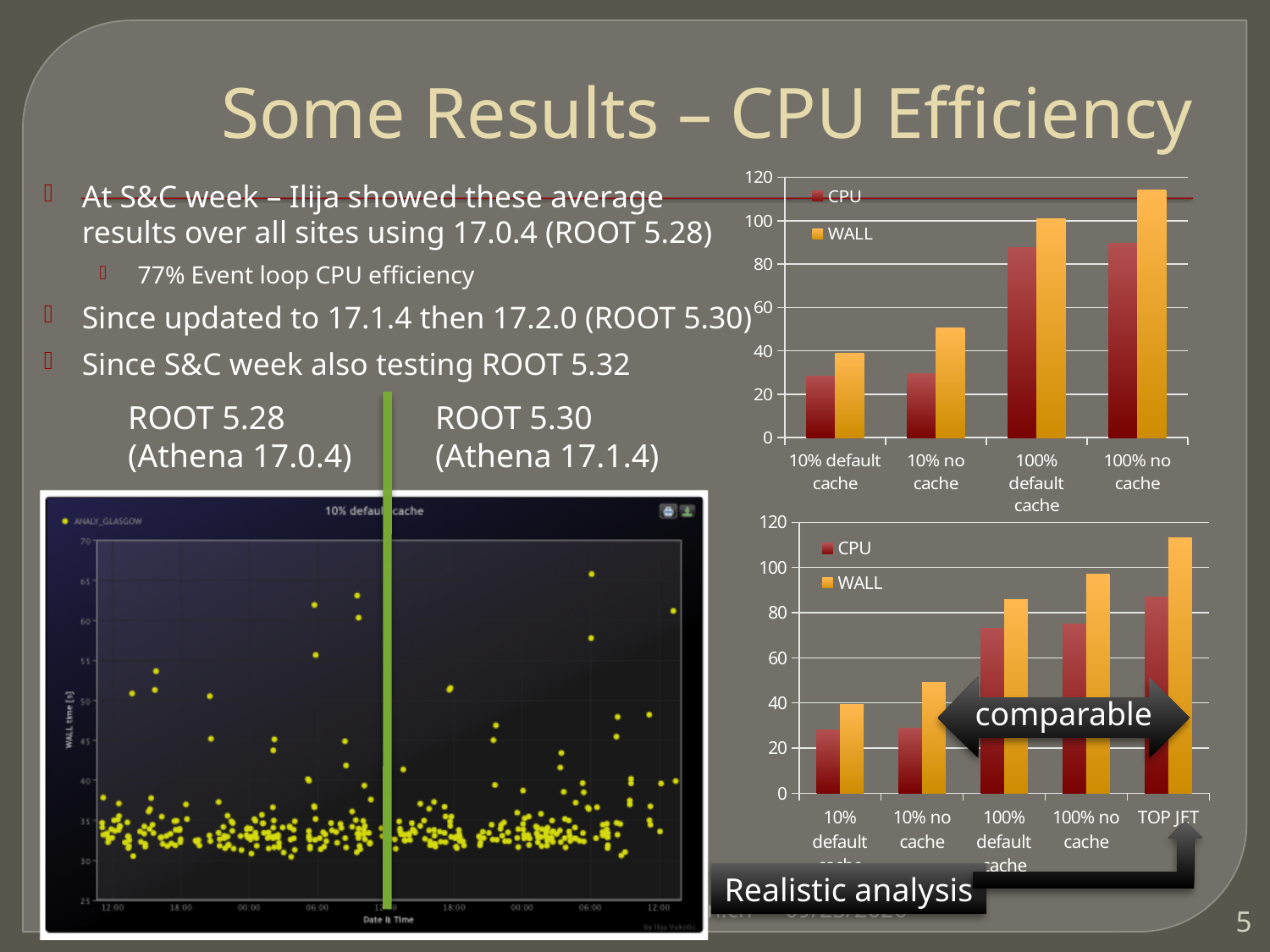
In the bottom-right chart, is the CPU value for 100% default cache greater or less than 60? greater In the bottom-right chart, which is larger for 100% no cache, the CPU value or the WALL value? WALL In the top-right chart, is the WALL value for 100% no cache greater or less than 100? greater What kind of chart is the top-right chart on the slide? bar chart In the top-right chart, which category has the highest WALL value? 100% no cache In the bottom-right chart, which category has the highest WALL value? TOP JET How many categories are shown on the x axis of the top-right chart? 4 How many categories are shown on the x axis of the bottom-right chart? 5 What are the two legend entries in the bottom-right chart? CPU and WALL How many series does the legend of the top-right chart list? 2 In the top-right chart, is the CPU value for 10% default cache greater or less than 40? less